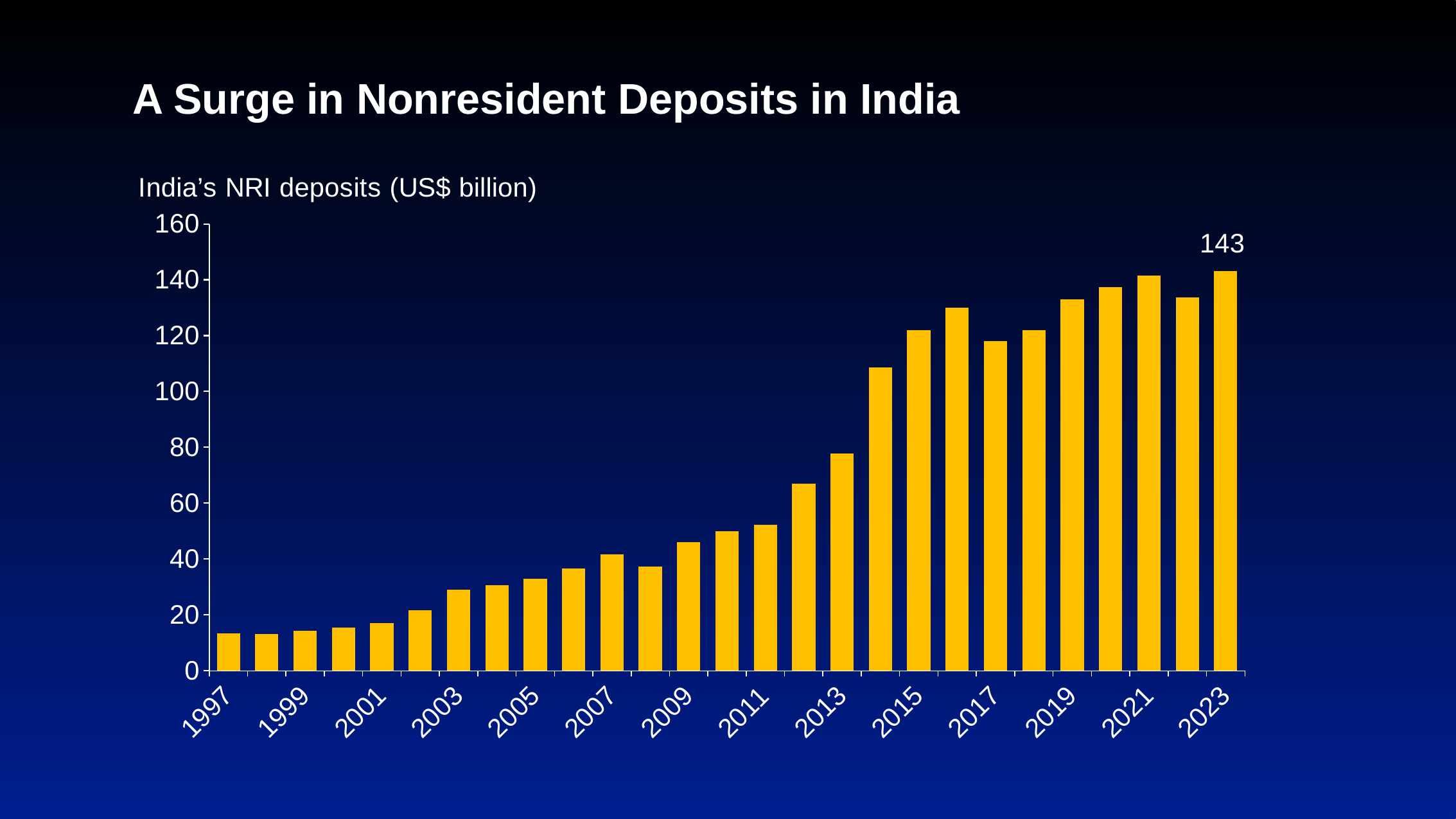
Which year has the highest NRI deposits? 2023 Which year has larger NRI deposits, 2021 or 2022? 2021 Do NRI deposits generally rise or fall from 1997 to 2023? Rise How many years (bars) are shown in the chart? 27 Is the value for 2022 greater or less than 140? less Is the value for 2001 greater or less than 20? less What kind of chart is shown on the slide? Bar chart Is the value for 2019 greater or less than 120? greater Which year has larger NRI deposits, 2016 or 2017? 2016 What unit is used for the values on the chart? US$ billion What is the value of India's NRI deposits for 2023? 143